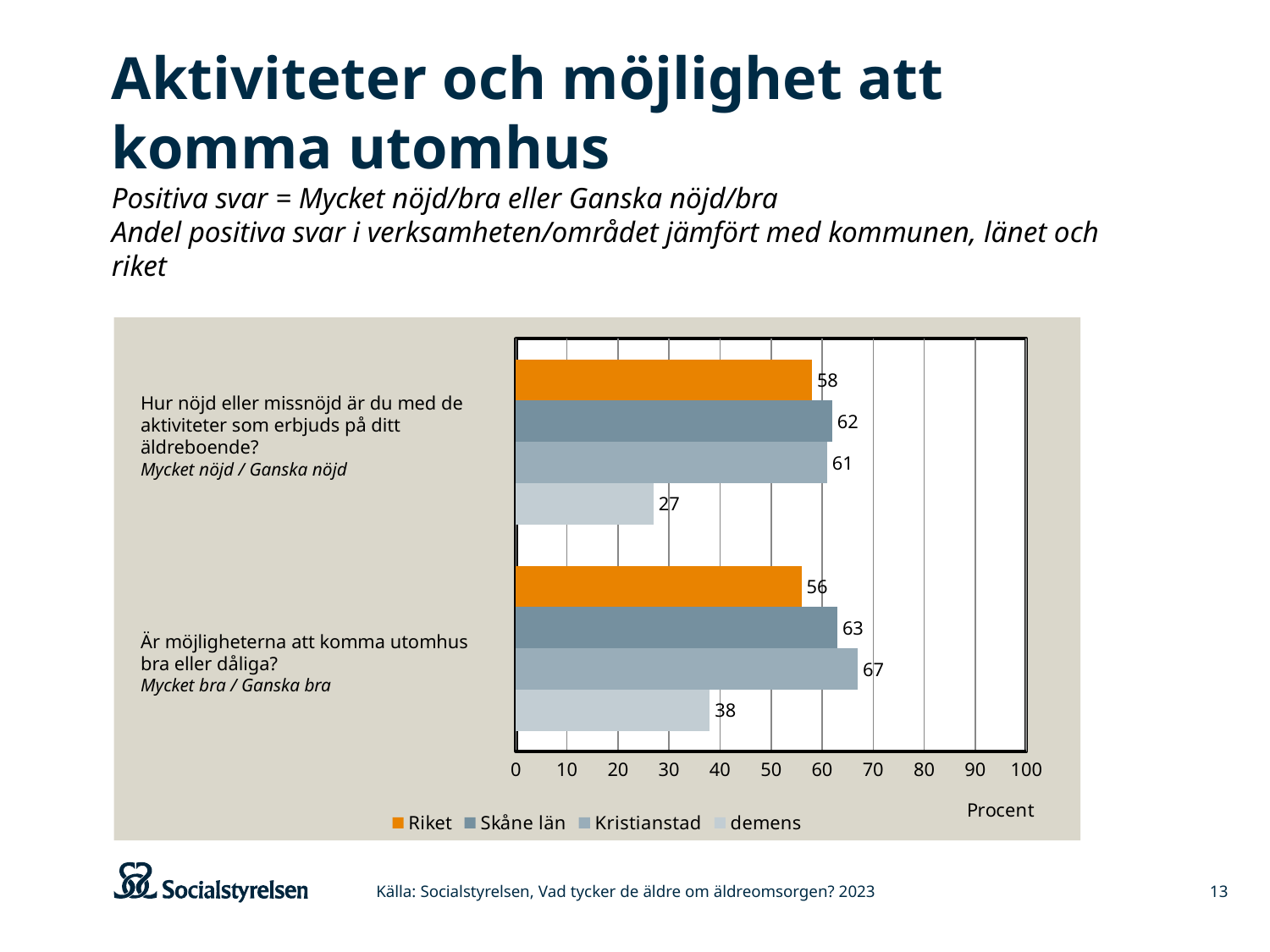
Which series has the highest value on the question about opportunities to get outdoors? Kristianstad How many series does the legend list? 4 What is the difference between Kristianstad and demens on the question about opportunities to get outdoors? 29 How many question categories are shown on the chart? 2 Which is larger on the question about satisfaction with activities: the value for Skåne län or the value for demens? Skåne län What is the value for demens on the question about satisfaction with activities offered at the care home? 27 What is the value for Skåne län on the question about opportunities to get outdoors? 63 What unit is shown on the x axis of the chart? Procent Which series has the lowest value on the question about opportunities to get outdoors? demens What is the value for Riket on the question about satisfaction with activities offered at the care home? 58 What is the value for Kristianstad on the question about opportunities to get outdoors? 67 What kind of chart is shown on the slide? Bar chart